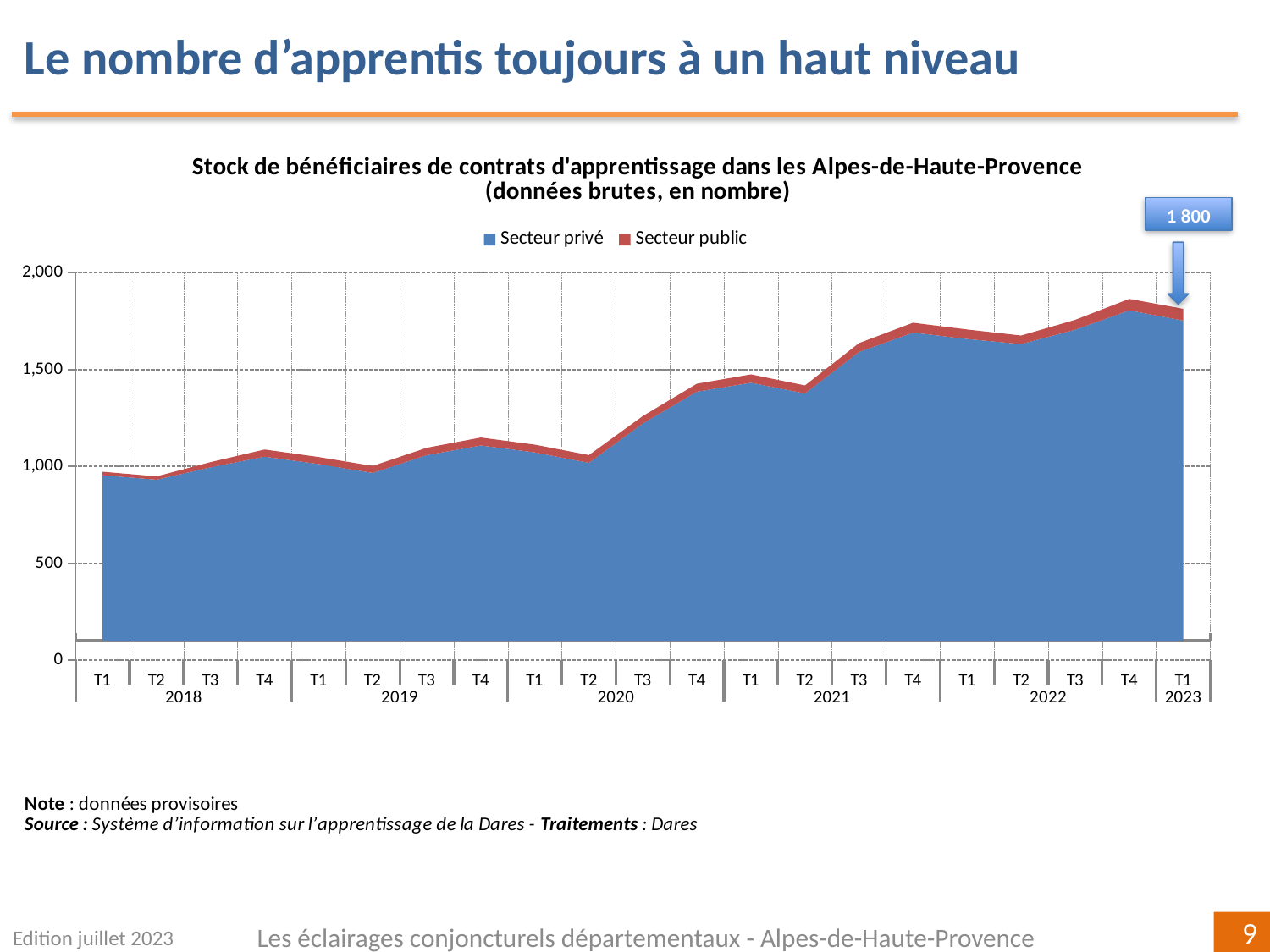
Which quarter has the highest total stock of beneficiaries? T4 2022 How many quarters are plotted along the x axis? 21 Which series accounts for the larger share of the stock, Secteur privé or Secteur public? Secteur privé Is the total value for T1 2018 greater or less than 1,000? less What kind of chart is shown on the slide? Stacked area chart Which is larger, the total for T4 2022 or the total for T1 2018? T4 2022 What is the total stock of apprenticeship contract beneficiaries indicated for T1 2023? 1 800 Is the total value for T3 2021 greater or less than 1,500? greater Overall, do the values rise or fall from T1 2018 to T1 2023? rise How many series does the legend list? 2 Is the total value for T4 2022 greater or less than 1,500? greater What are the two series named in the legend? Secteur privé and Secteur public